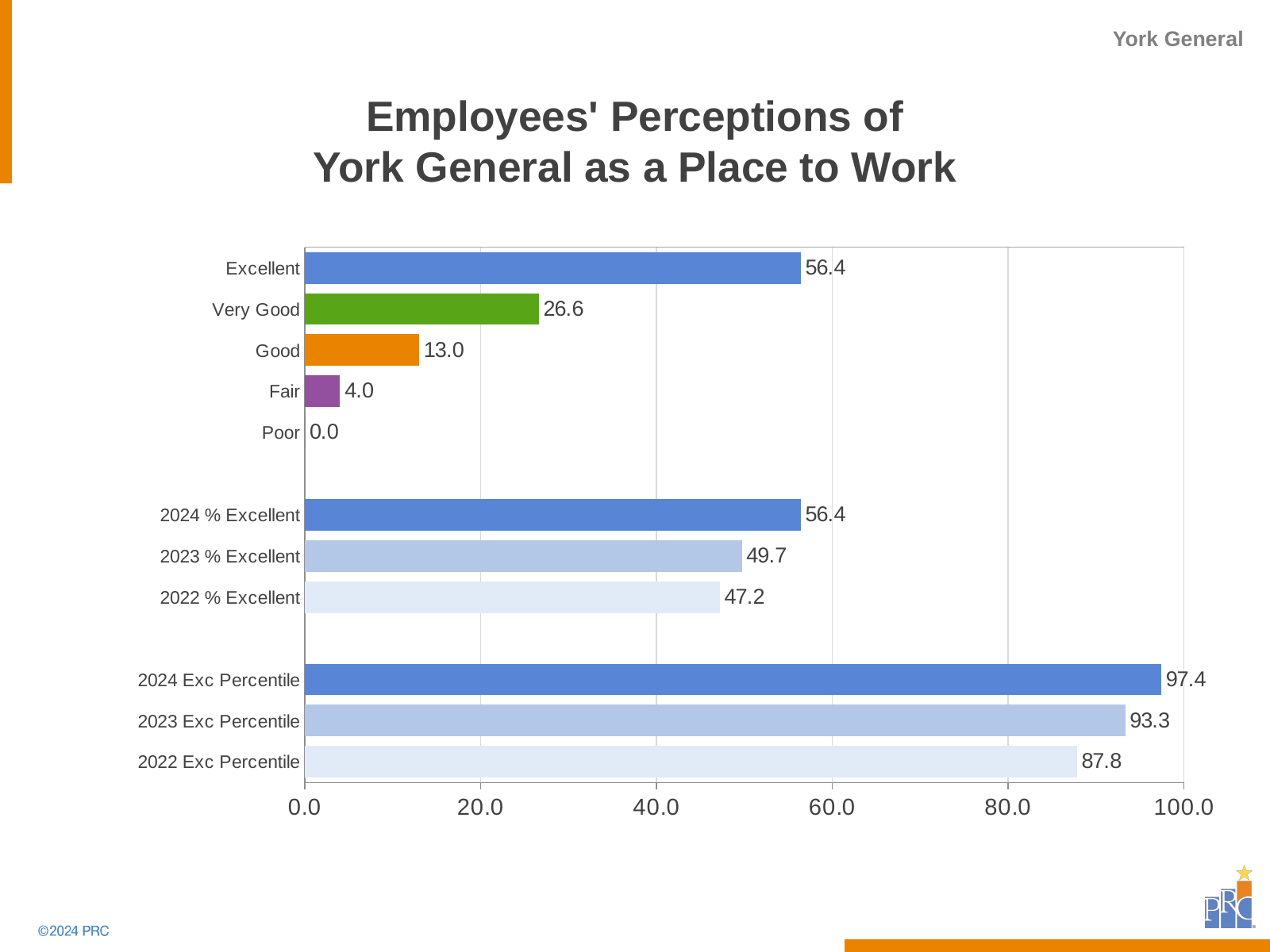
What is the value for Very Good? 26.6 What is the value for 2023 % Excellent? 49.7 What is the title of the chart? Employees' Perceptions of York General as a Place to Work What kind of chart is shown on the slide? Bar chart Which is larger, the value for 2023 Exc Percentile or 2022 Exc Percentile? 2023 Exc Percentile What is the value for 2022 Exc Percentile? 87.8 What is the difference between the 2024 % Excellent and 2022 % Excellent values? 9.2 Which category has the highest value on the chart? 2024 Exc Percentile Which category has the lowest value on the chart? Poor Is the value for 2024 Exc Percentile greater or less than 80.0? greater What is the value for Excellent? 56.4 What is the difference between the Good and Fair values? 9.0